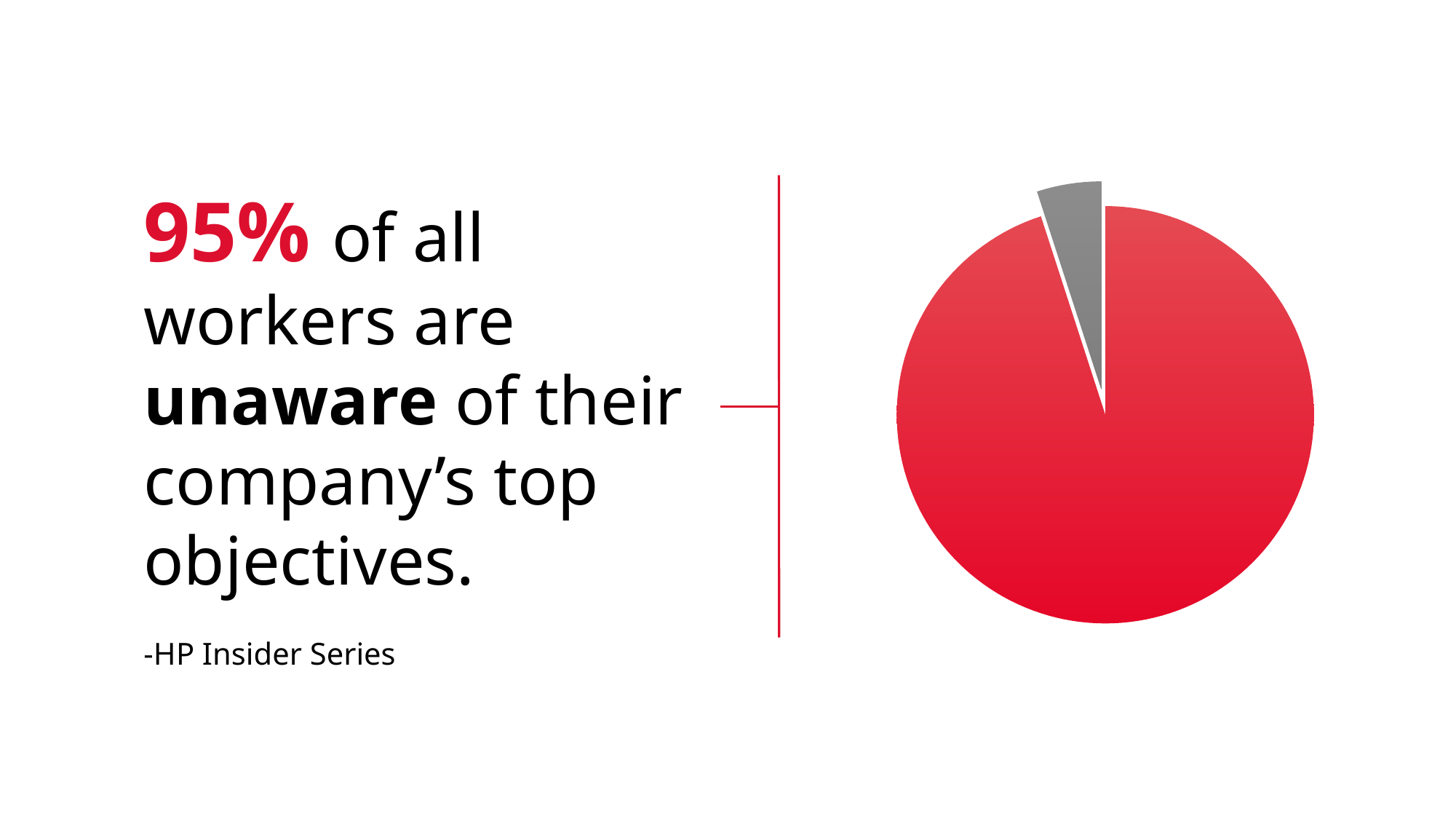
Which slice of the pie chart is the largest? the red slice What kind of chart is shown on the slide? pie chart Is the share of the red slice greater or less than 50%? greater Is the share of the grey slice greater or less than 10%? less How many slices does the pie chart have? 2 What share of the pie does the red slice represent? 95% What share of the pie does the grey slice represent? 5% Which slice of the pie chart is the smallest? the grey slice What source is cited for the statistic shown with the pie chart? HP Insider Series Is the red slice or the grey slice larger? the red slice What colour is the slice representing workers who are unaware of their company's top objectives? red